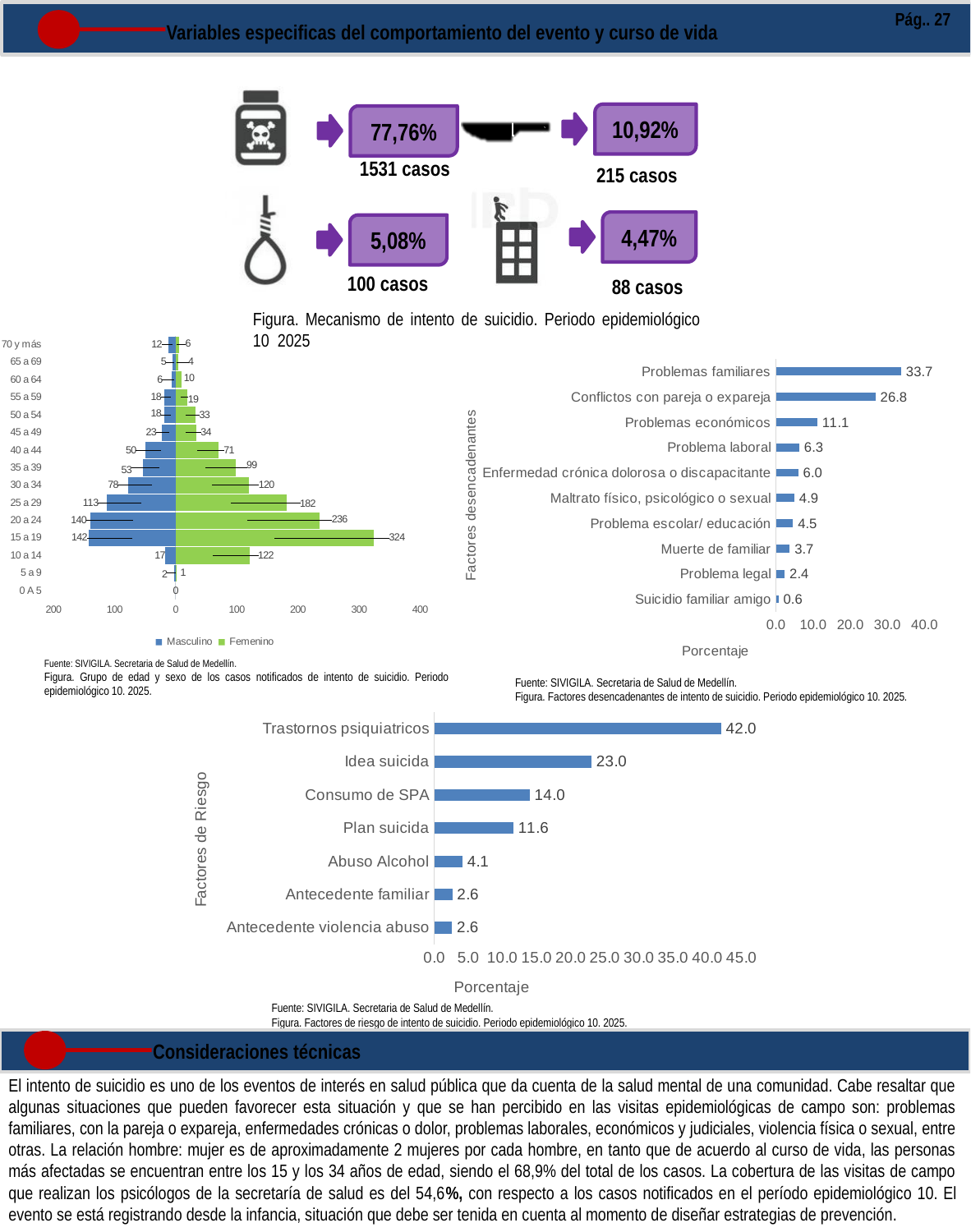
In the 'Factores desencadenantes' chart, what is the value for Problemas familiares? 33.7 In the 'Factores de Riesgo' chart, which factor has the highest value? Trastornos psiquiatricos In the 'Factores desencadenantes' chart, which factor has the lowest value? Suicidio familiar amigo How many series does the legend of the age group and sex chart list? 2 In the 'Factores de Riesgo' chart, what is the value for Trastornos psiquiatricos? 42.0 In the 'Factores desencadenantes' chart, what is the difference between Problemas familiares and Conflictos con pareja o expareja? 6.9 How many categories are shown in the 'Factores de Riesgo' chart? 7 In the age group and sex chart (bottom left), what is the Femenino value for the 15 a 19 age group? 324 In the age group and sex chart (bottom left), what is the Masculino value for the 20 a 24 age group? 140 What kind of chart is the 'Factores de Riesgo' chart? Bar chart In the 'Factores de Riesgo' chart, which is larger: Consumo de SPA or Plan suicida? Consumo de SPA How many categories are shown in the 'Factores desencadenantes' chart? 10